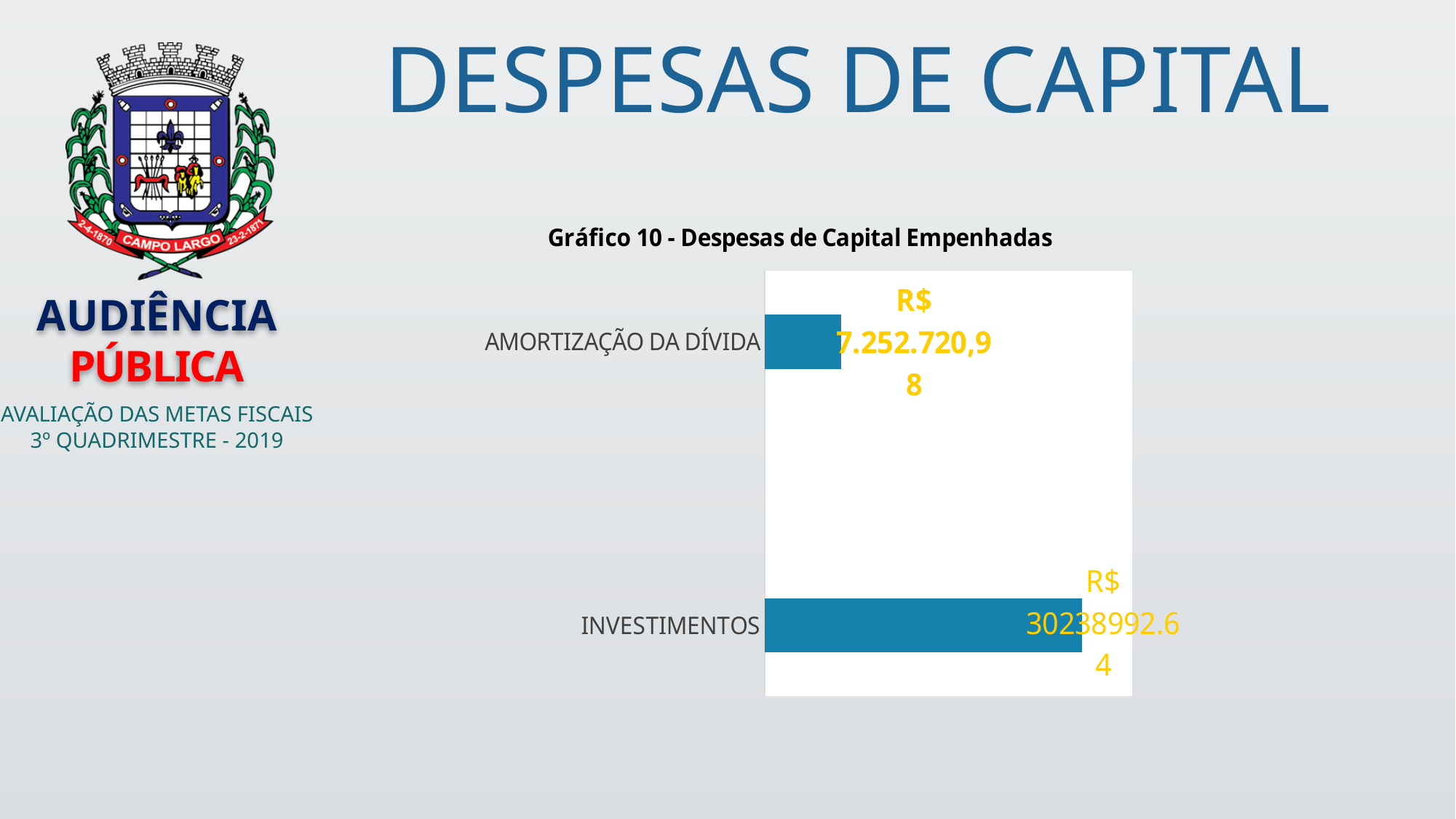
Which is larger, the value for INVESTIMENTOS or the value for AMORTIZAÇÃO DA DÍVIDA? INVESTIMENTOS What is the title of the chart? Gráfico 10 - Despesas de Capital Empenhadas What is the value shown for AMORTIZAÇÃO DA DÍVIDA? R$ 7.252.720,98 How many categories are plotted in the chart? 2 What colour are the bars in the chart? Blue What kind of chart is shown on the slide? Bar chart Which category has the highest value? INVESTIMENTOS What is the value shown for INVESTIMENTOS? R$ 30238992.64 Which category has the lowest value? AMORTIZAÇÃO DA DÍVIDA